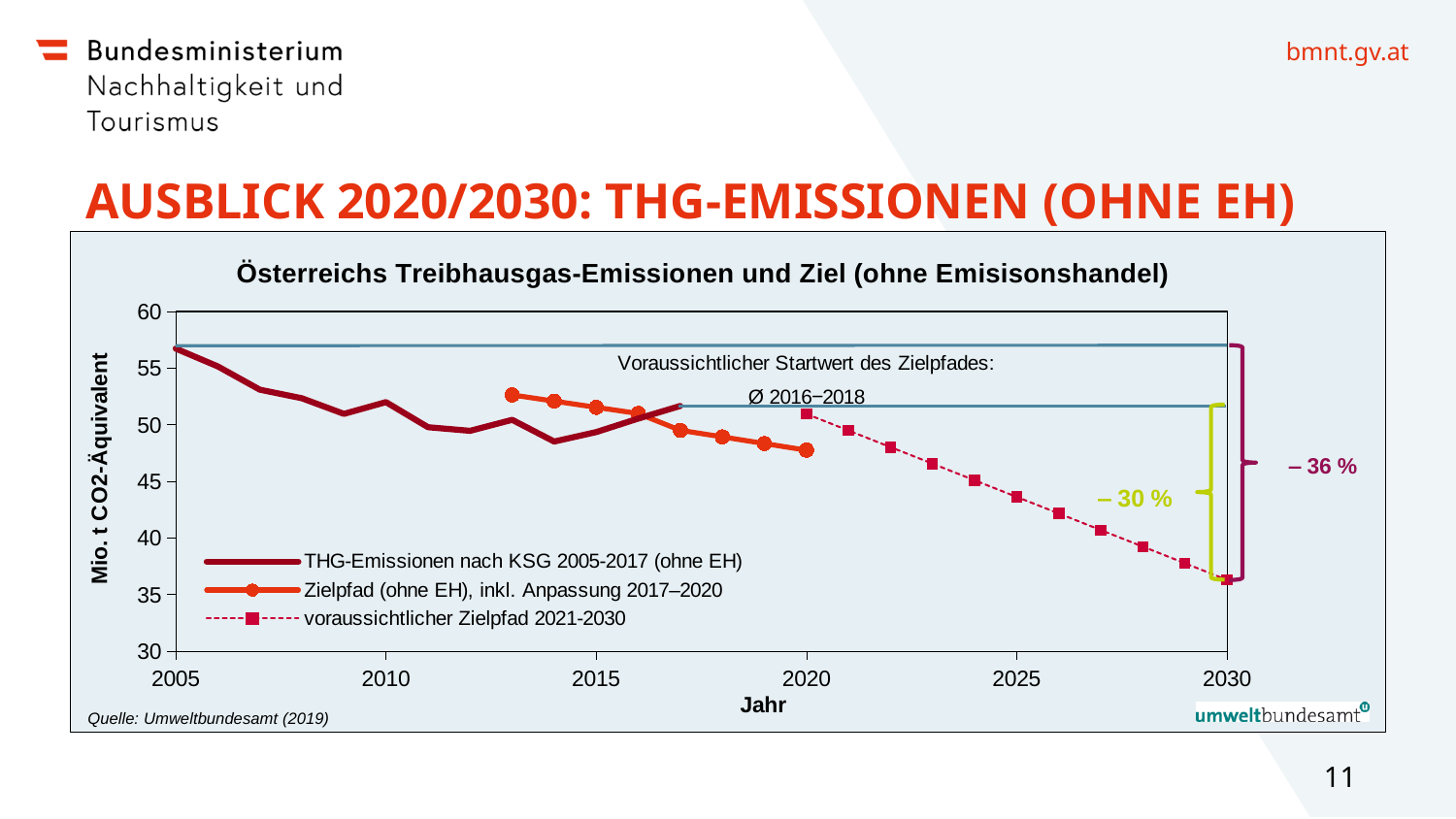
Is the Zielpfad (ohne EH), inkl. Anpassung 2017–2020 value for 2020 greater or less than 50? less What is the label of the y axis of the chart? Mio. t CO2-Äquivalent Is the THG-Emissionen nach KSG 2005-2017 (ohne EH) value for 2005 greater or less than 55? greater What kind of chart is shown on the slide? Line chart What percentage reduction is annotated between the 2016–2018 average start value and the 2030 target? – 30 % Is the voraussichtlicher Zielpfad 2021-2030 value for 2030 greater or less than 40? less What is the title of the chart? Österreichs Treibhausgas-Emissionen und Ziel (ohne Emisisonshandel) What percentage reduction is annotated between the 2005 level and the 2030 target? – 36 % How many series does the chart legend list? 3 Which is larger: the THG-Emissionen nach KSG value for 2005 or for 2017? 2005 Do the THG-Emissionen nach KSG 2005-2017 (ohne EH) values generally rise or fall from 2005 to 2017? Fall In which year is the THG-Emissionen nach KSG 2005-2017 (ohne EH) series at its highest? 2005